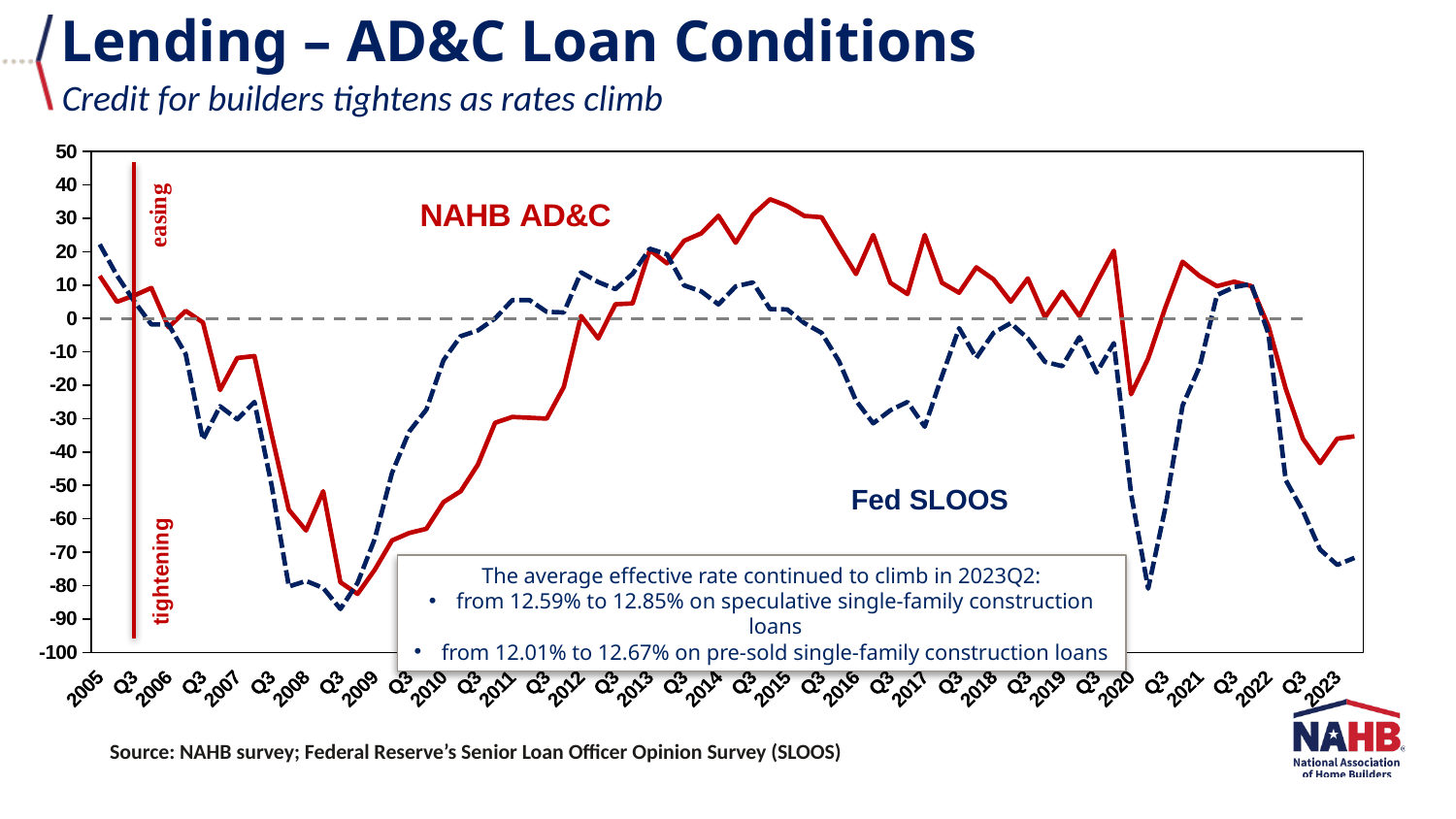
What is the title of the slide containing the chart? Lending – AD&C Loan Conditions Is the value of the Fed SLOOS series at 2023 greater or less than -50? less Which series is drawn as a dashed line? Fed SLOOS Is the value of the NAHB AD&C series at 2015 greater or less than 20? greater How many data series are plotted on the chart? 2 At 2016, which series has the higher value, NAHB AD&C or Fed SLOOS? NAHB AD&C What kind of chart is shown on the slide? Line chart Does the NAHB AD&C series rise or fall between 2022 and 2023? Fall Is the value of the NAHB AD&C series at 2009 greater or less than -60? less At 2023, which series has the higher value, NAHB AD&C or Fed SLOOS? NAHB AD&C